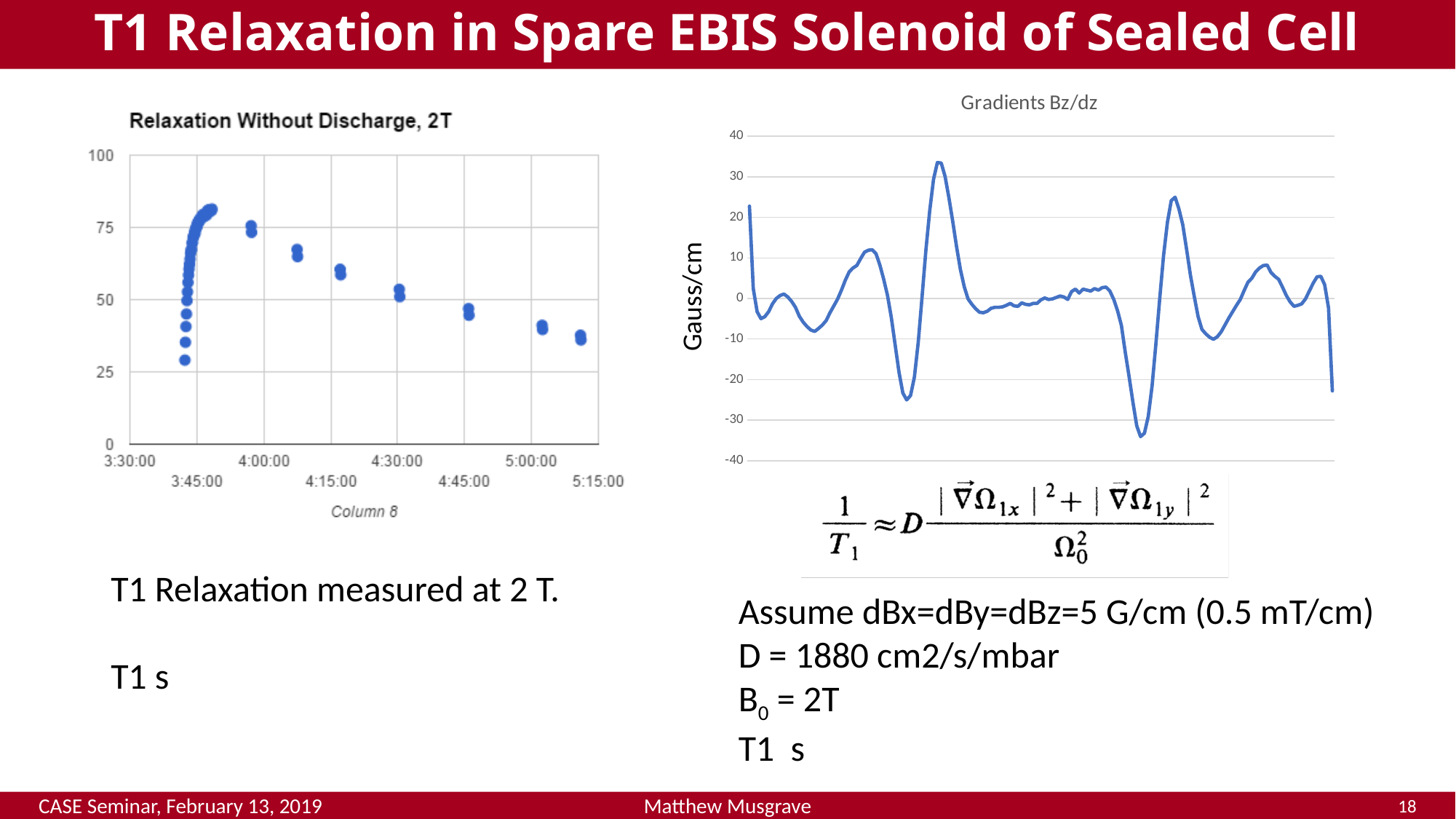
In the 'Relaxation Without Discharge, 2T' chart, which is larger: the value near 4:00:00 or the value near 4:45:00? the value near 4:00:00 What is the x-axis label of the 'Relaxation Without Discharge, 2T' chart? Column 8 What is the title of the chart on the left of the slide? Relaxation Without Discharge, 2T What is the y-axis label of the 'Gradients Bz/dz' chart? Gauss/cm In the 'Gradients Bz/dz' chart, is the highest peak of the line greater or less than 30? greater What kind of chart is the 'Gradients Bz/dz' chart on the right of the slide? line chart In the 'Relaxation Without Discharge, 2T' chart, do the values rise or fall along the x axis after the peak near 3:50:00? fall In the 'Gradients Bz/dz' chart, is the lowest trough of the line greater or less than -30? less In the 'Relaxation Without Discharge, 2T' chart, is the value of the last data points near 5:10:00 greater or less than 50? less What kind of chart is the chart on the left of the slide, titled 'Relaxation Without Discharge, 2T'? scatter chart